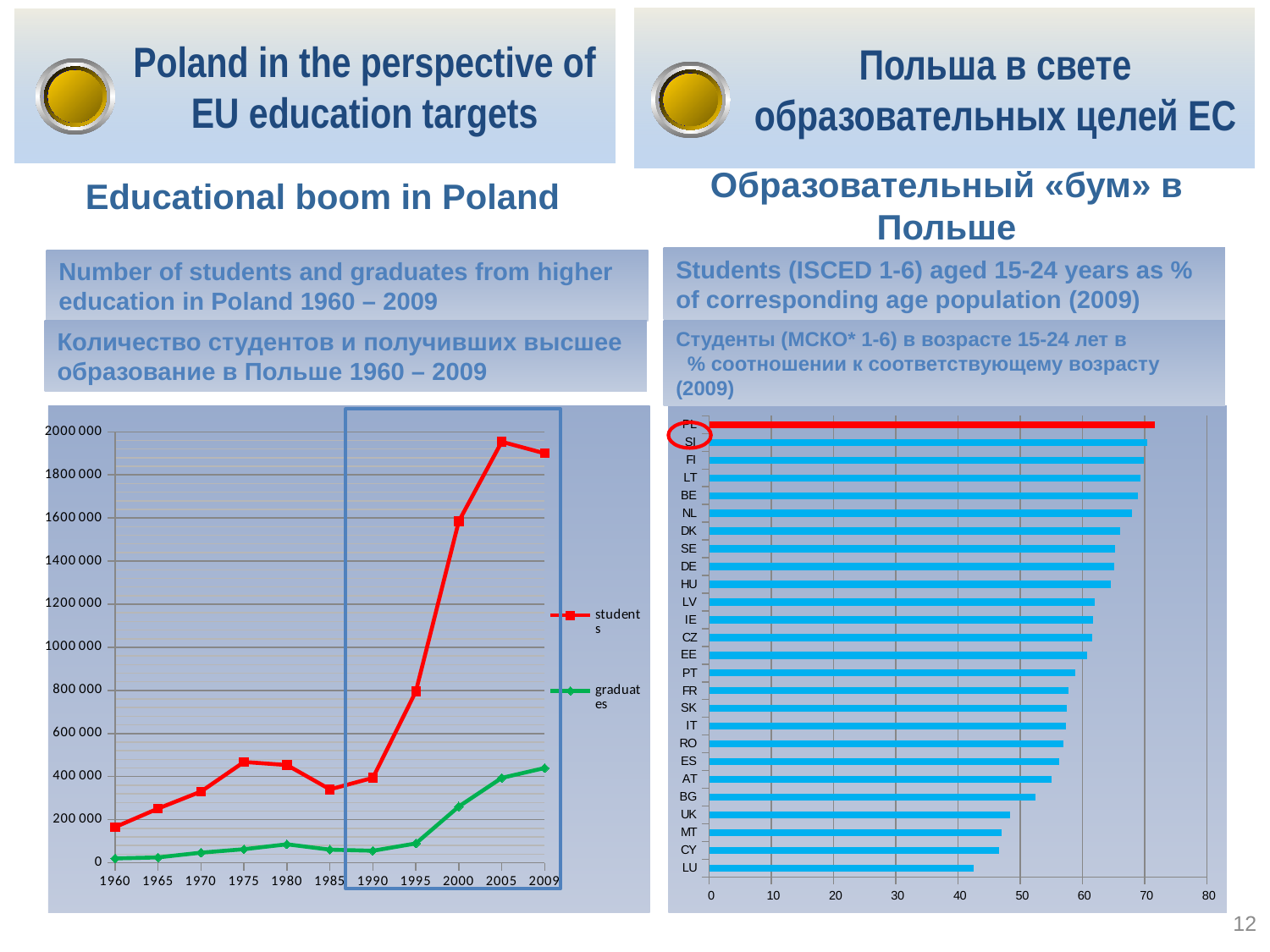
In the left chart (students and graduates in Poland), how many years are plotted along the x axis? 11 In the left chart (students and graduates in Poland), does the number of graduates rise or fall between 1990 and 2009? rise In the left chart (students and graduates in Poland), is the number of students in 1960 greater or less than 200 000? less What kind of chart is the left chart, 'Number of students and graduates from higher education in Poland 1960 – 2009'? line chart In the right chart (students aged 15-24 as % of age population, 2009), is the value for LU greater or less than 50? less In the left chart (students and graduates in Poland), is the number of students in 2005 greater or less than 1800 000? greater What kind of chart is the right chart, 'Students (ISCED 1-6) aged 15-24 years as % of corresponding age population (2009)'? bar chart In the left chart (students and graduates in Poland), in which year is the number of students highest? 2005 In the left chart (students and graduates in Poland), which series has the larger value in 2009, students or graduates? students In the left chart (students and graduates in Poland), how many series does the legend list? 2 In the right chart (students aged 15-24 as % of age population, 2009), how many countries are shown? 26 In the right chart (students aged 15-24 as % of age population, 2009), which country has the lowest value? LU